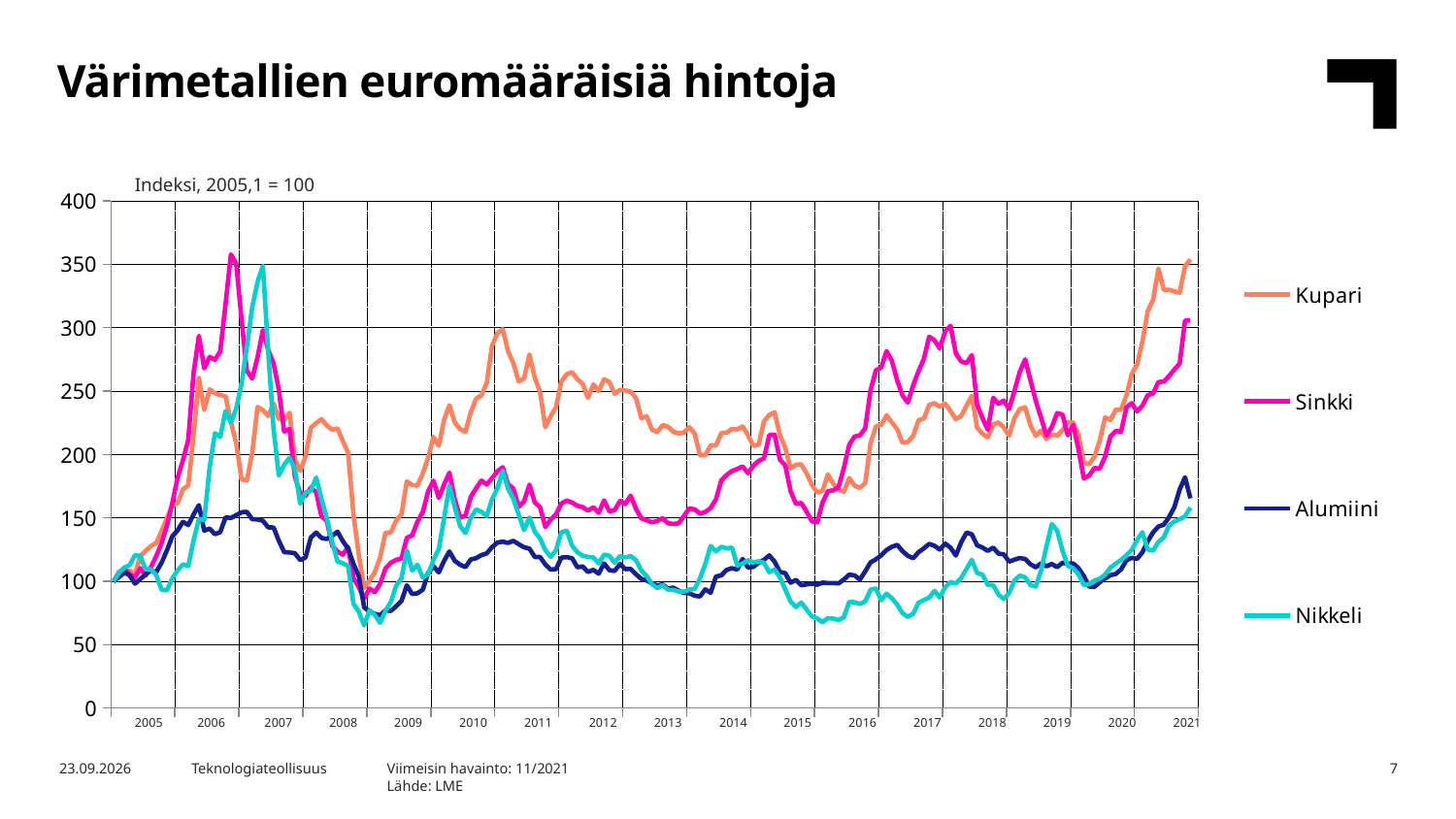
What kind of chart is shown on the slide? Line chart At the end of 2021, which series is higher, Kupari or Alumiini? Kupari How many series does the legend list? 4 Is the value for Kupari at the end of 2021 greater or less than 300? greater What base period is the index set to 100, according to the axis label? 2005,1 Is the value for Nikkeli in 2016 greater or less than 100? less What is the title of the chart? Värimetallien euromääräisiä hintoja How many year labels are shown on the x axis? 17 Is the value for Alumiini at the end of 2021 greater or less than 150? greater Which series has the lowest value at the end of 2021? Nikkeli Does the Kupari series rise or fall from 2019 to 2021? Rise